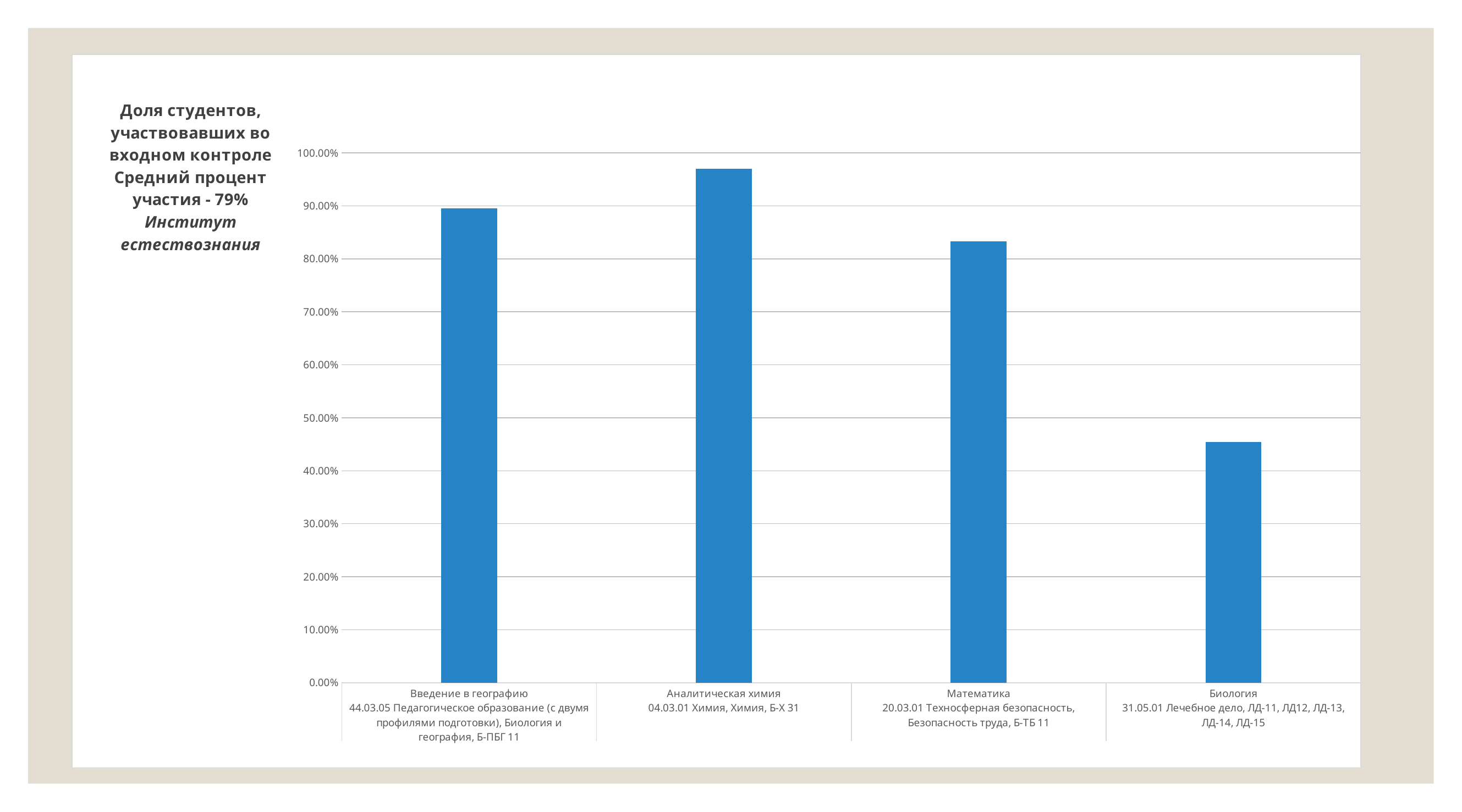
How many categories (bars) are plotted in the chart? 4 Which category has the highest bar? Аналитическая химия Which institute is named in the chart title? Институт естествознания What kind of chart is shown on the slide? Bar chart Is the value for Биология greater or less than 50.00%? less Which category has the lowest bar? Биология What average participation percentage is stated in the chart title? 79% Which is larger, the value for Введение в географию or the value for Математика? Введение в географию Is the value for Аналитическая химия greater or less than 90.00%? greater Is the value for Математика greater or less than 80.00%? greater Which is larger, the value for Биология or the value for Аналитическая химия? Аналитическая химия